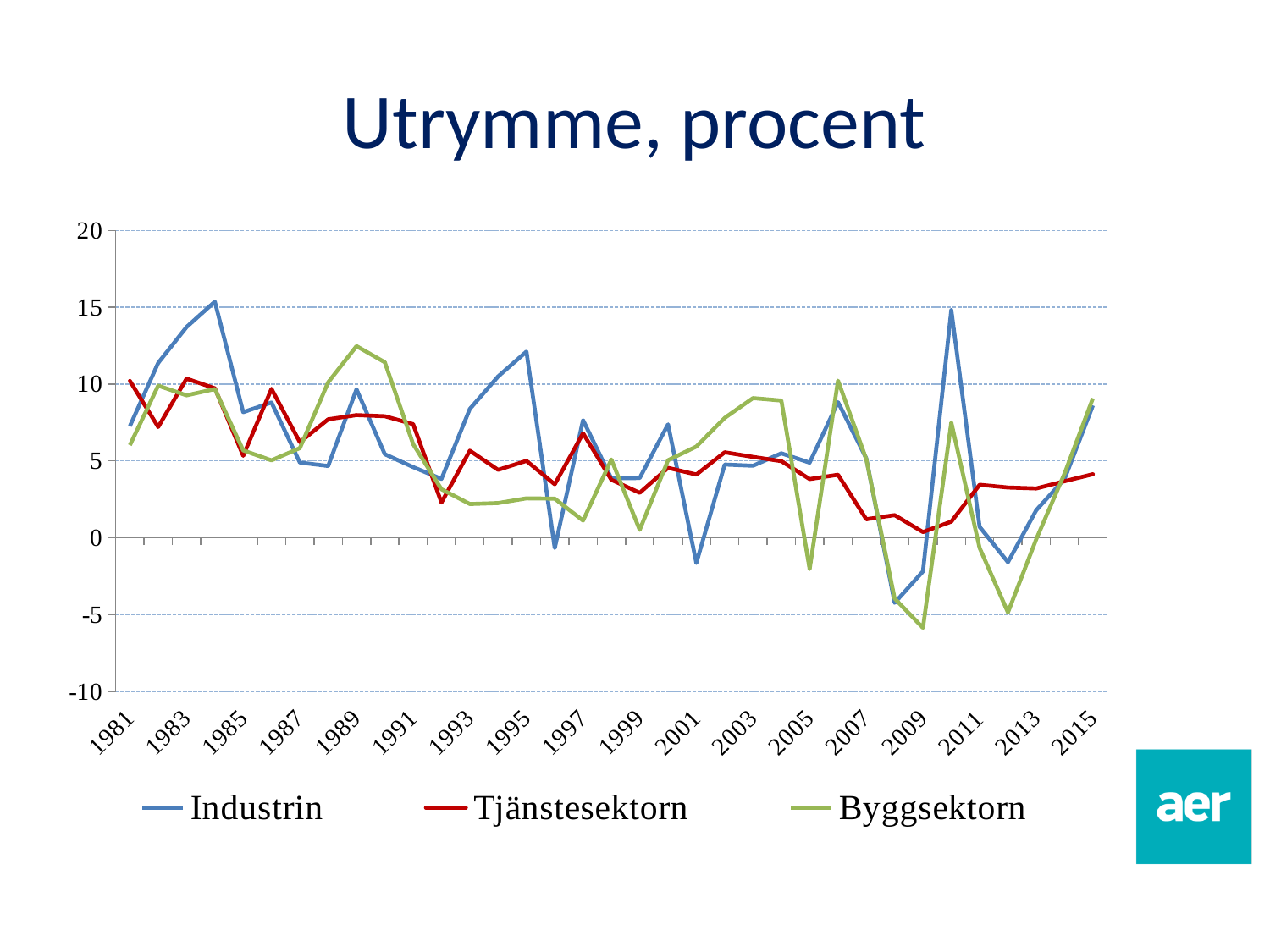
How many years are labelled on the x axis? 18 Is the value for Industrin in 2010 greater or less than 10? greater Which series reaches the highest value anywhere on the chart? Industrin Which series reaches the lowest value anywhere on the chart? Byggsektorn What is the title of the chart? Utrymme, procent How many series does the legend list? 3 Does the Tjänstesektorn series overall rise or fall from 1981 to 2015? fall Is the value for Byggsektorn in 1989 greater or less than 10? greater Which series is drawn in red? Tjänstesektorn Is the value for Byggsektorn in 2009 greater or less than 0? less What kind of chart is shown on the slide? Line chart In 1989, which is larger: Byggsektorn or Industrin? Byggsektorn